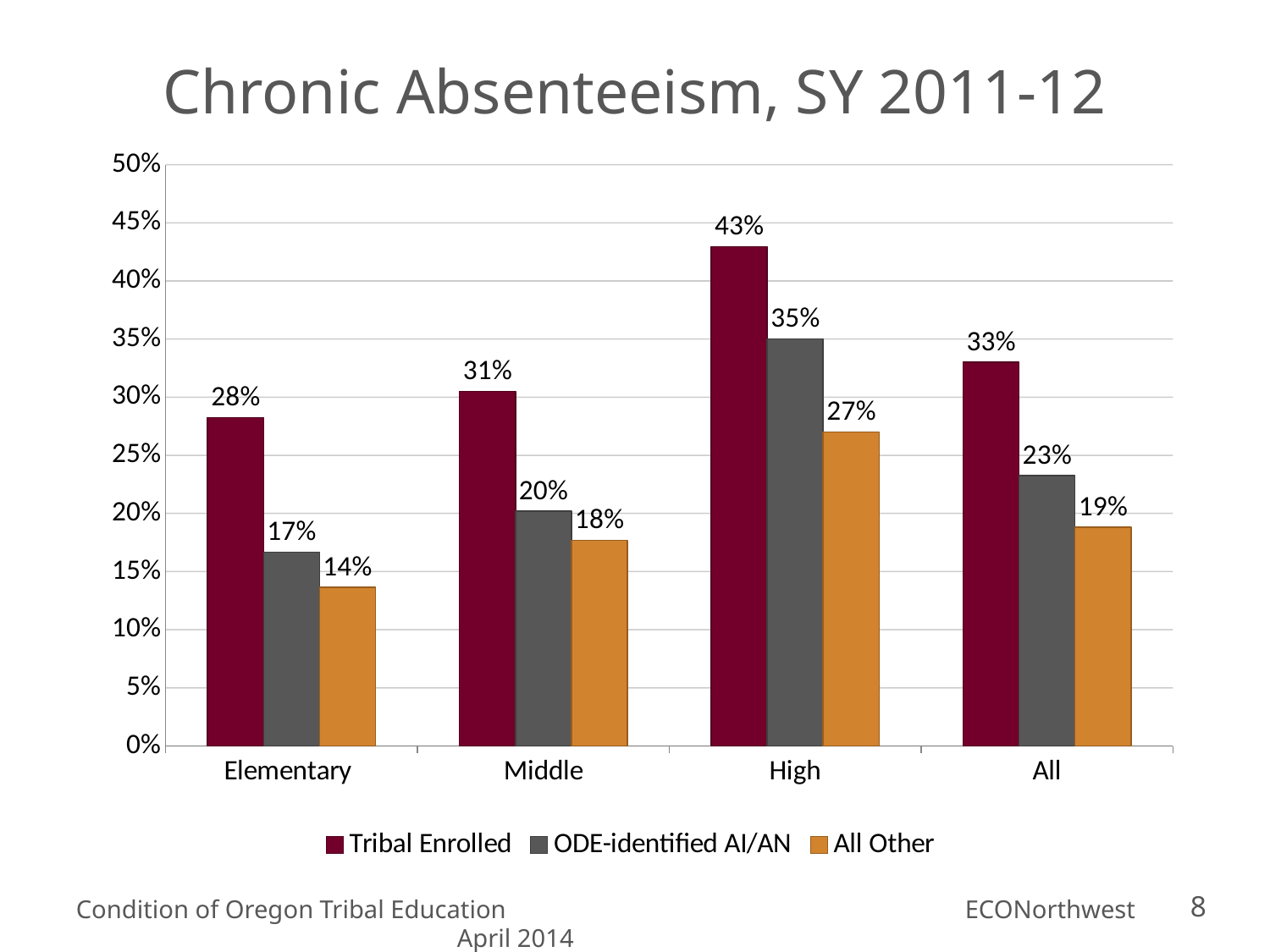
Which school level has the lowest chronic absenteeism rate for All Other students? Elementary Which school level has the highest chronic absenteeism rate for Tribal Enrolled students? High What is the value for ODE-identified AI/AN students in the Middle category? 20% What is the value for All Other students in the Elementary category? 14% What kind of chart is shown on the slide? Bar chart What is the difference between the Tribal Enrolled and All Other rates in the All category? 14% What is the chronic absenteeism rate for Tribal Enrolled students at the High school level? 43% What is the title of the chart? Chronic Absenteeism, SY 2011-12 How many series does the legend list? 3 Is the Tribal Enrolled value for Elementary greater or less than 25%? greater Which is larger at the Middle level: the ODE-identified AI/AN rate or the All Other rate? ODE-identified AI/AN How many categories are shown on the x axis? 4